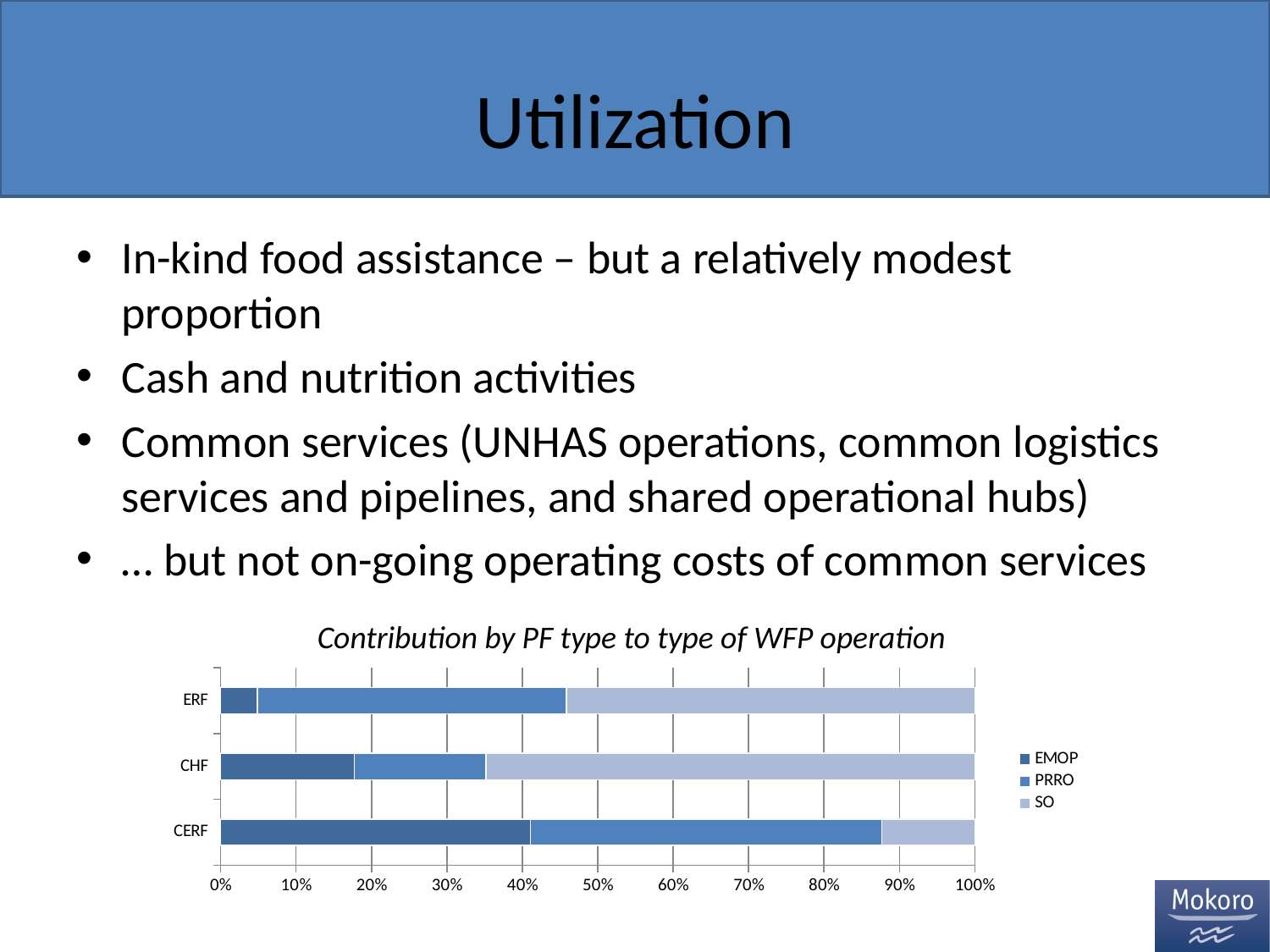
What is the title of the chart? Contribution by PF type to type of WFP operation Is the EMOP share for CERF greater or less than 30%? greater How many PF type categories are plotted on the chart? 3 What is the total of the stacked bar for CHF? 100% What kind of chart is shown on the slide? bar chart Which PF type has the smallest SO share of its bar? CERF Which PF type has the largest EMOP share of its bar? CERF Is the EMOP share for ERF greater or less than 10%? less Is the EMOP share for CERF larger or smaller than the EMOP share for CHF? larger How many series does the chart legend list? 3 Which PF type has the largest SO share of its bar? CHF Which PF type has the smallest EMOP share of its bar? ERF